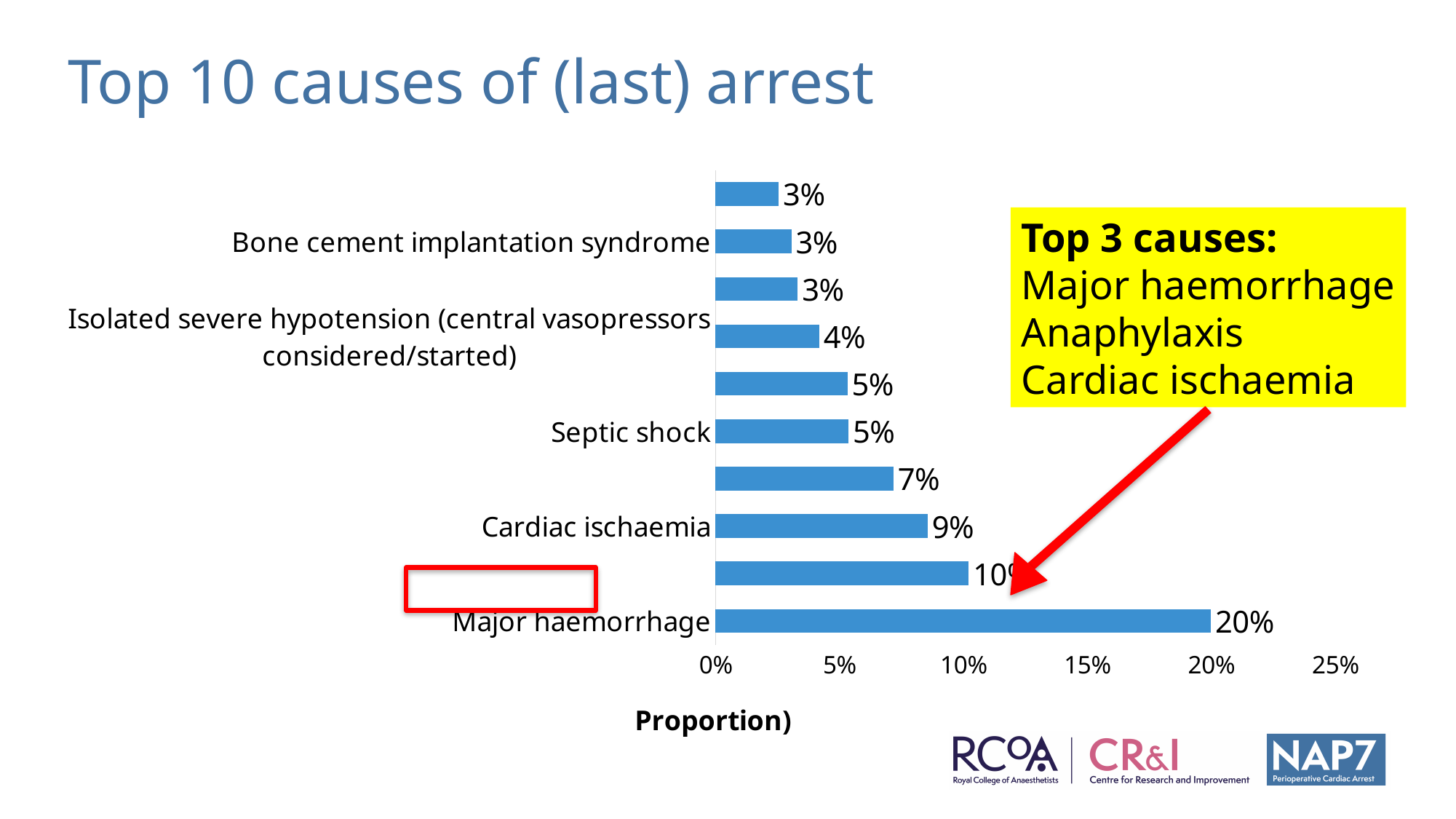
How many bars are plotted in the chart? 10 Is the value for Major haemorrhage greater or less than 15%? greater What is the value for Septic shock? 5% What is the difference between the values for Major haemorrhage and Cardiac ischaemia? 11% What is the value for Isolated severe hypotension (central vasopressors considered/started)? 4% Which cause has the highest proportion? Major haemorrhage What is the value for Cardiac ischaemia? 9% Which is larger, the value for Septic shock or the value for Bone cement implantation syndrome? Septic shock What is the value for Major haemorrhage? 20% What is the highest tick value shown on the x axis? 25% What kind of chart is shown on the slide? bar chart What is the value for Bone cement implantation syndrome? 3%